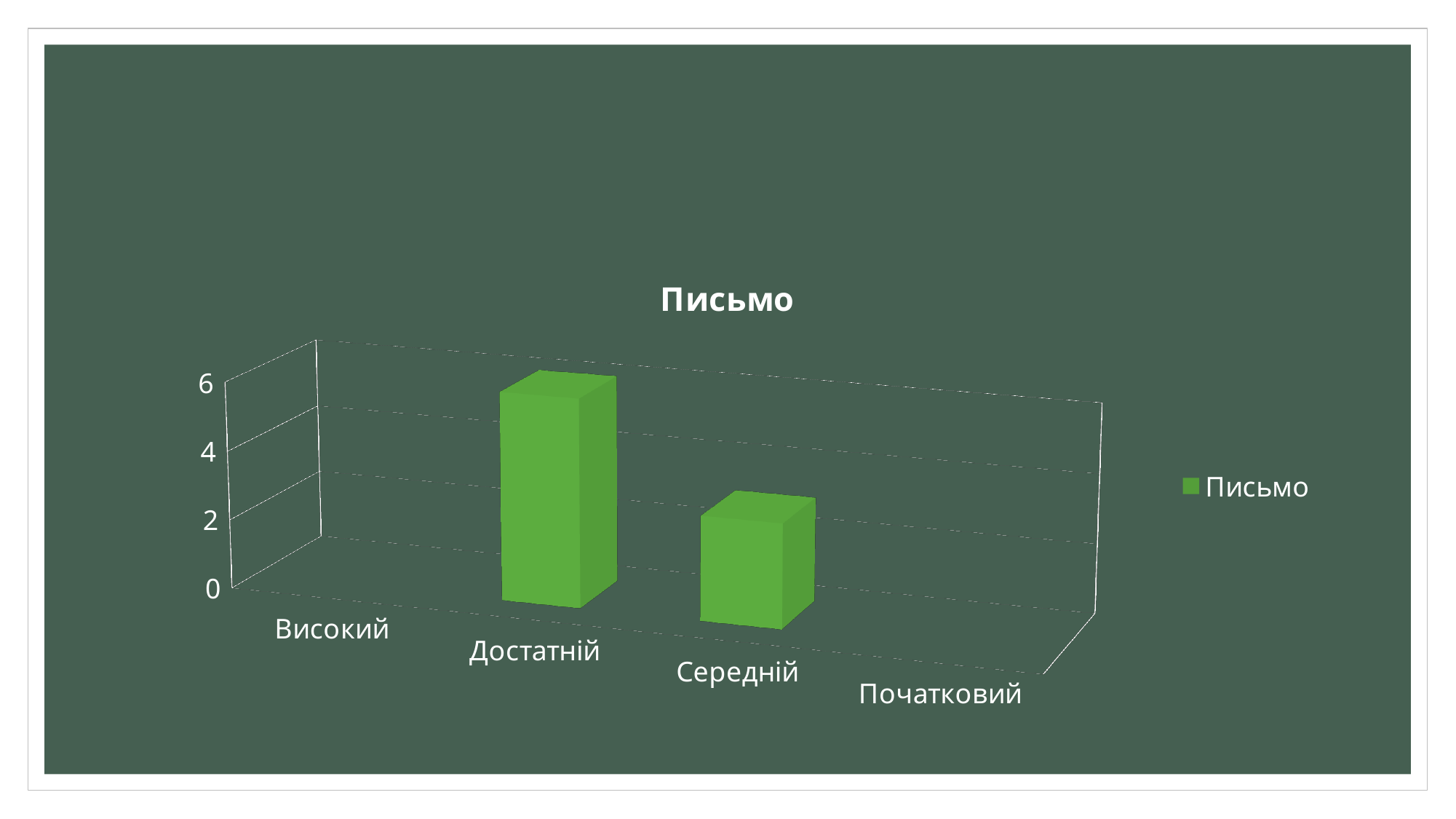
What series name is shown in the legend? Письмо Which category has the highest bar? Достатній How many series does the legend list? 1 How many categories are shown on the x axis of the chart? 4 What kind of chart is shown on the slide? bar chart Which is larger, the value for Достатній or the value for Середній? Достатній What is the title of the chart? Письмо Is the value for Достатній greater or less than 2? greater Is the value for Достатній greater or less than 4? greater Is the value for Середній greater or less than 4? less Which is larger, the value for Середній or the value for Високий? Середній